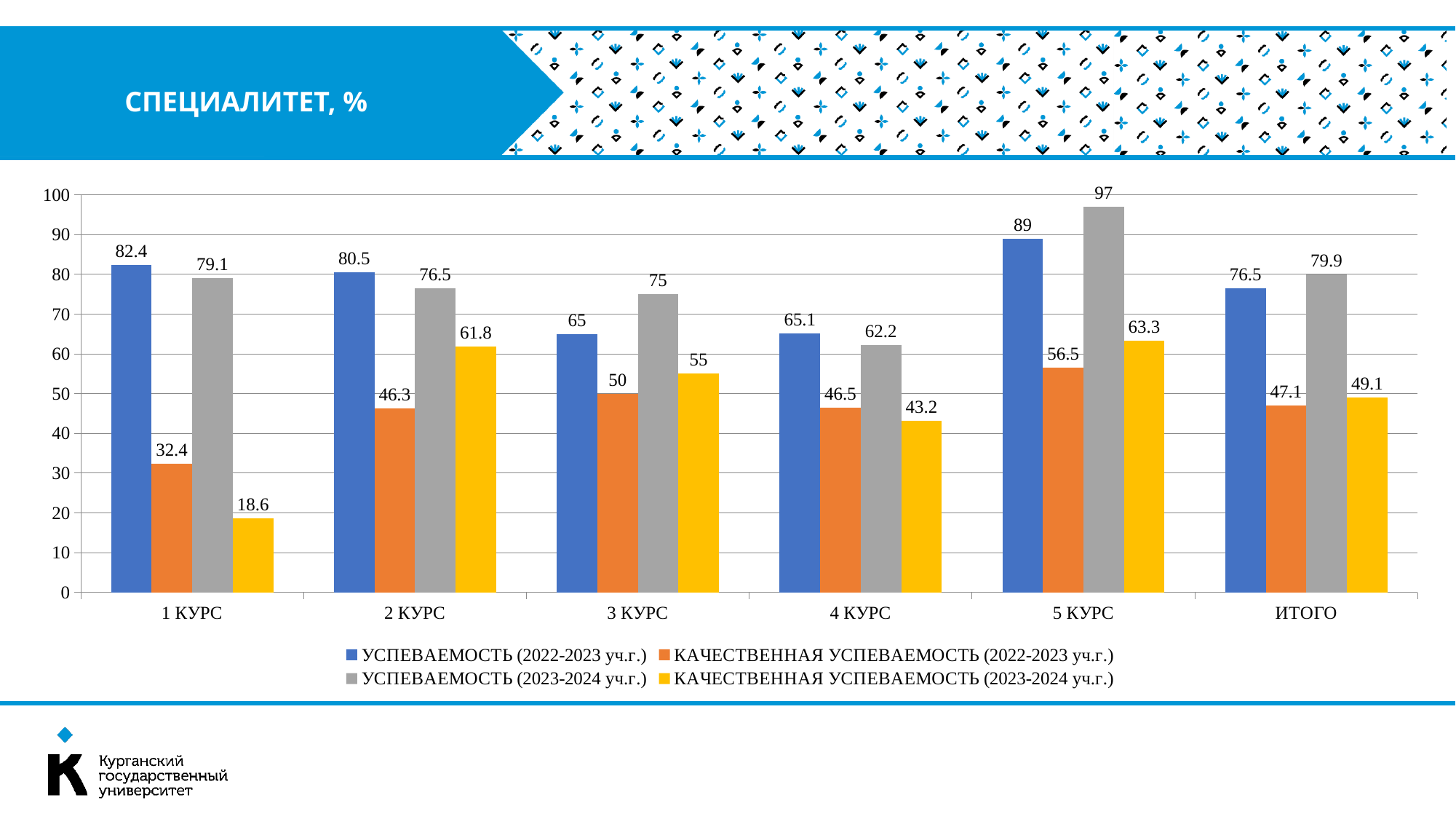
Which is larger for 2 КУРС: КАЧЕСТВЕННАЯ УСПЕВАЕМОСТЬ (2022-2023 уч.г.) or КАЧЕСТВЕННАЯ УСПЕВАЕМОСТЬ (2023-2024 уч.г.)? КАЧЕСТВЕННАЯ УСПЕВАЕМОСТЬ (2023-2024 уч.г.) Is the value of УСПЕВАЕМОСТЬ (2023-2024 уч.г.) for 4 КУРС greater or less than 70? less What is the value of КАЧЕСТВЕННАЯ УСПЕВАЕМОСТЬ (2023-2024 уч.г.) for ИТОГО? 49.1 Which category has the lowest value for КАЧЕСТВЕННАЯ УСПЕВАЕМОСТЬ (2023-2024 уч.г.)? 1 КУРС How many series does the legend list? 4 Which category has the highest value for УСПЕВАЕМОСТЬ (2022-2023 уч.г.)? 5 КУРС What is the title of the slide? СПЕЦИАЛИТЕТ, % What is the difference between УСПЕВАЕМОСТЬ (2023-2024 уч.г.) and УСПЕВАЕМОСТЬ (2022-2023 уч.г.) for 3 КУРС? 10 How many categories are shown on the x axis? 6 What kind of chart is shown on the slide? bar chart What is the value of УСПЕВАЕМОСТЬ (2023-2024 уч.г.) for 5 КУРС? 97 What is the value of КАЧЕСТВЕННАЯ УСПЕВАЕМОСТЬ (2022-2023 уч.г.) for 1 КУРС? 32.4